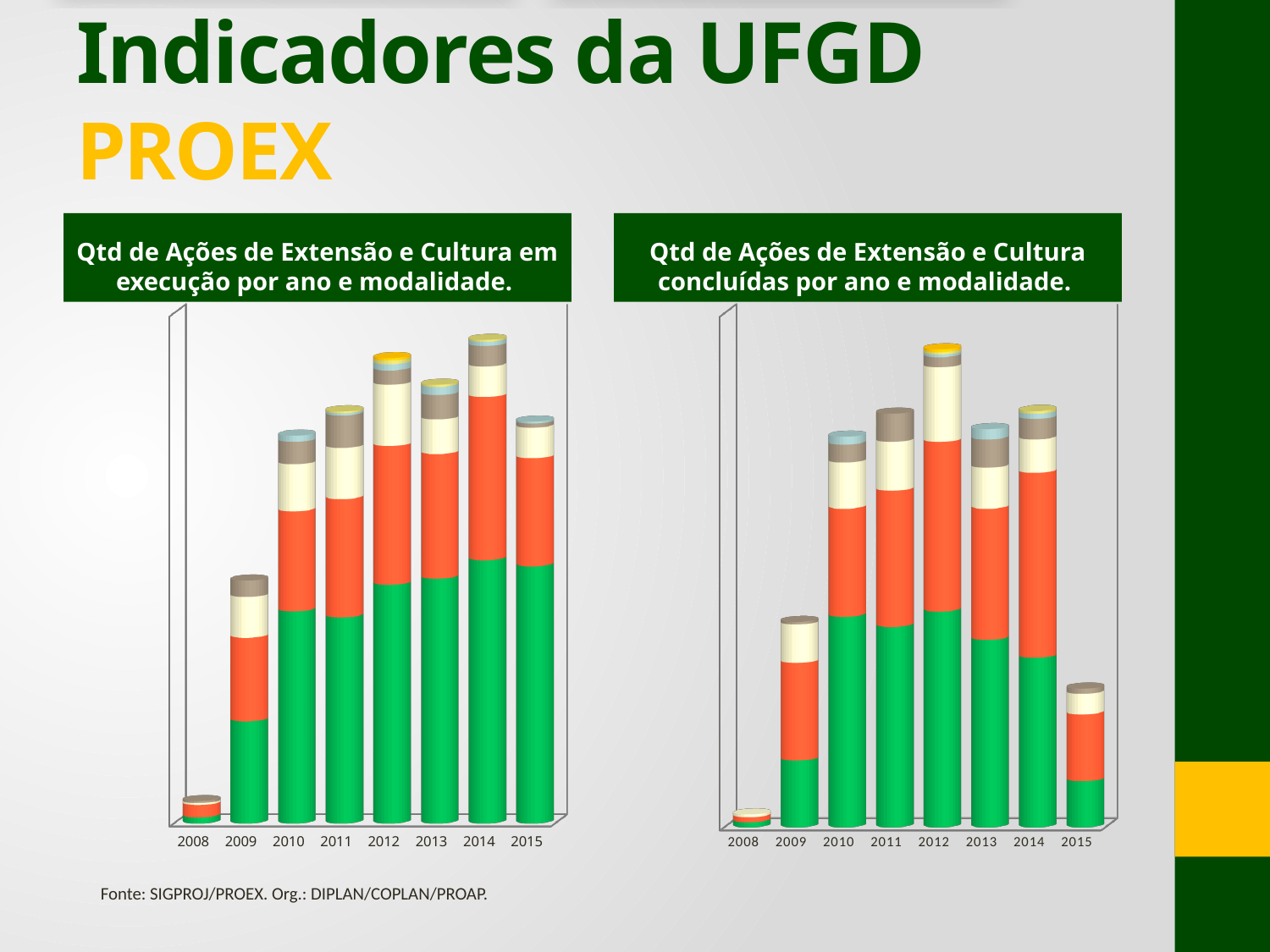
In the left chart (ações em execução), which year has the shortest stacked bar? 2008 In the left chart (ações em execução), how many years are shown on the x axis? 8 In the right chart (ações concluídas), which bar is taller, 2009 or 2015? 2009 In the left chart (ações em execução), do the stacked bars generally rise or fall from 2008 to 2014? Rise What kind of chart is the right chart, 'Qtd de Ações de Extensão e Cultura concluídas por ano e modalidade'? Stacked bar chart In the right chart (ações concluídas), which year has the tallest stacked bar? 2012 In the right chart (ações concluídas), which year has the shortest stacked bar? 2008 What is the title of the right chart? Qtd de Ações de Extensão e Cultura concluídas por ano e modalidade. In the left chart (ações em execução), which bar is taller, 2009 or 2015? 2015 What kind of chart is the left chart, 'Qtd de Ações de Extensão e Cultura em execução por ano e modalidade'? Stacked bar chart In the left chart (ações em execução), which year has the tallest stacked bar? 2014 In the right chart (ações concluídas), how many years are shown on the x axis? 8